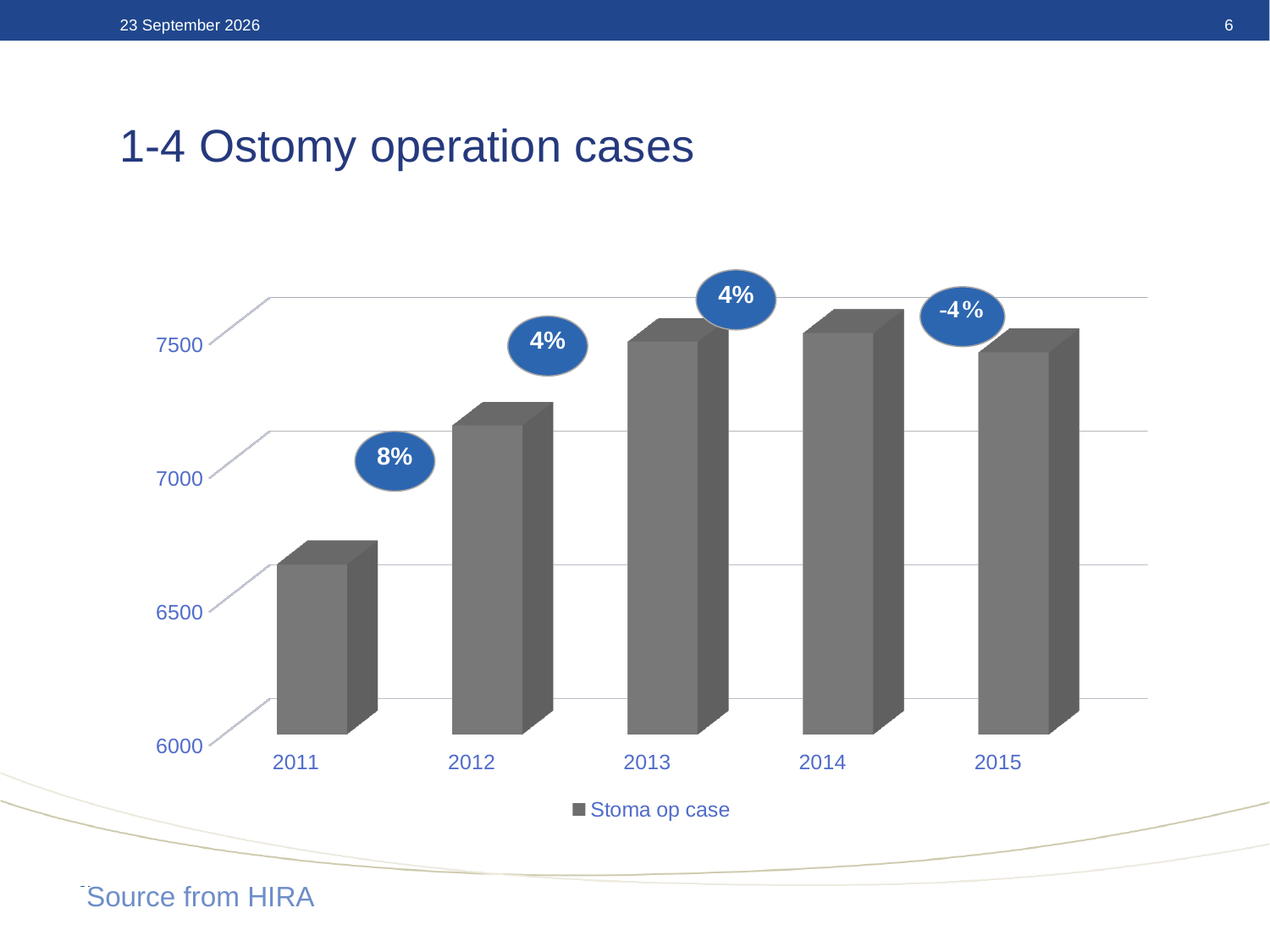
How many years are shown on the x axis of the chart? 5 Do the values rise or fall from 2011 to 2014? rise Is the value for 2014 greater or less than 7000? greater Is the value for 2011 greater or less than 7000? less What kind of chart is shown on the slide? bar chart Which year has the lowest number of stoma op cases? 2011 Is the value for 2011 greater or less than 6500? greater How many series does the chart's legend list? 1 What is the name of the series shown in the chart's legend? Stoma op case Which is larger, the value for 2011 or the value for 2013? 2013